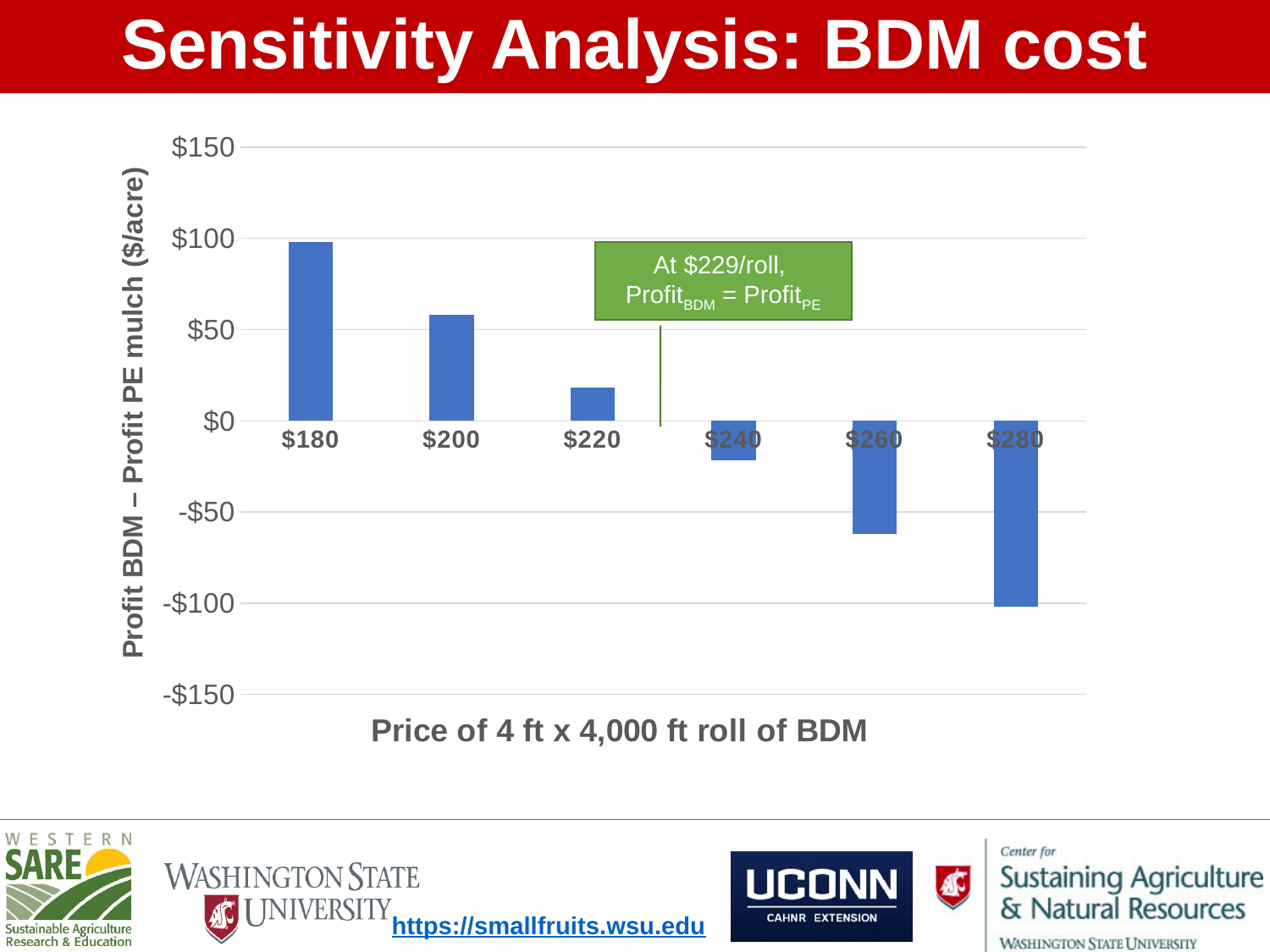
According to the annotation on the chart, at what roll price does Profit BDM equal Profit PE? $229/roll Is the value for the $280 roll price greater or less than -$50? less Is the value for the $220 roll price greater or less than $50? less What is the title of the x axis? Price of 4 ft x 4,000 ft roll of BDM Which has a larger value, the $180 roll price or the $200 roll price? $180 Which BDM roll price has the highest value of Profit BDM – Profit PE mulch? $180 How many price categories are shown on the x axis? 6 Which BDM roll price has the lowest value of Profit BDM – Profit PE mulch? $280 Is the value for the $240 roll price greater or less than -$50? greater Do the values rise or fall as the price of the BDM roll increases along the x axis? fall What kind of chart is shown on the slide? bar chart